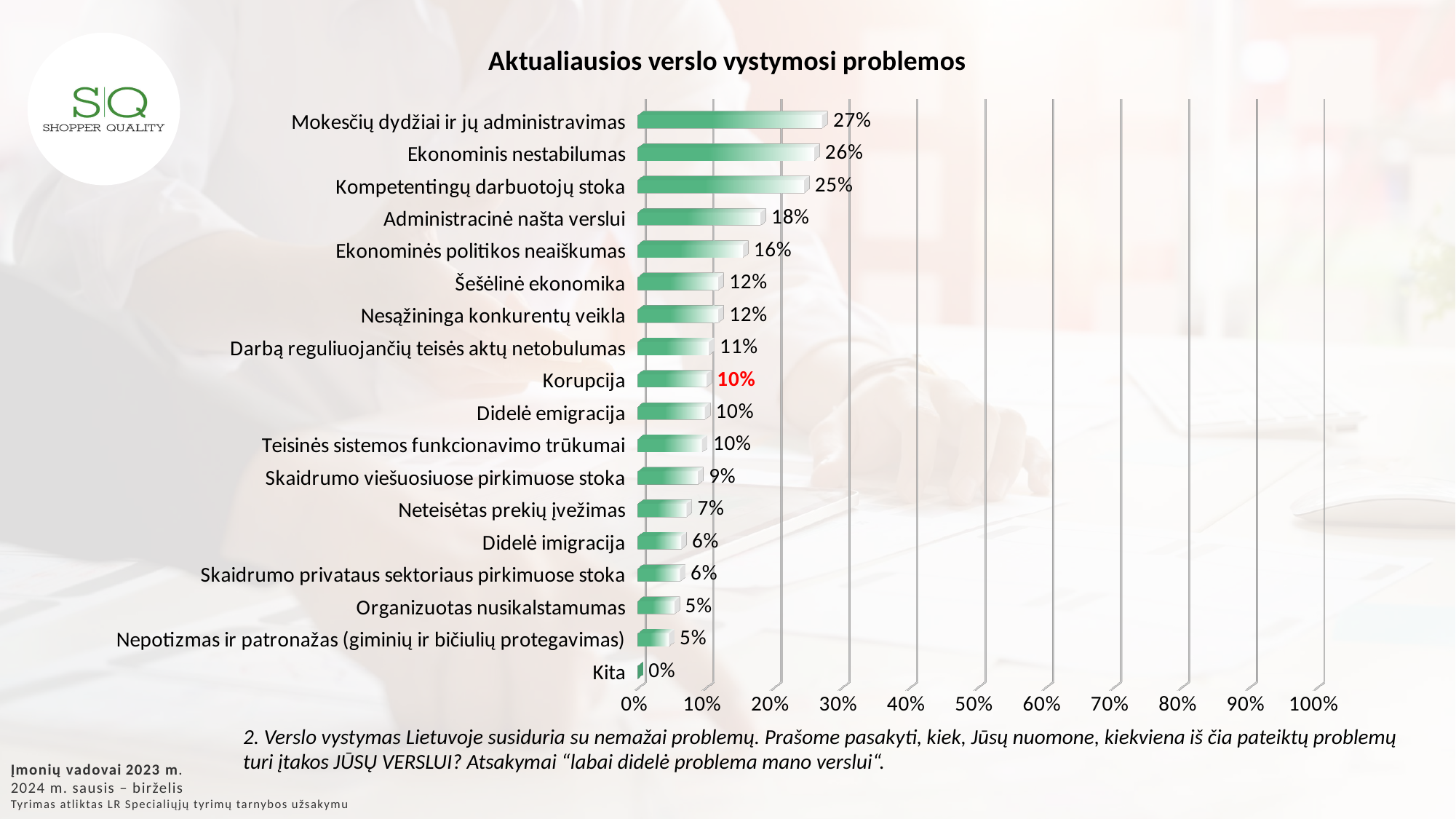
What is the value for Mokesčių dydžiai ir jų administravimas? 27% Which is larger, the value for Kompetentingų darbuotojų stoka or the value for Šešėlinė ekonomika? Kompetentingų darbuotojų stoka What is the value for Neteisėtas prekių įvežimas? 7% Which category has the highest value? Mokesčių dydžiai ir jų administravimas What is the value for Korupcija? 10% Is the value for Ekonominis nestabilumas greater or less than 20%? greater How many categories are shown in the chart? 18 Which category has the lowest value? Kita What kind of chart is shown on the slide? bar chart What is the value for Administracinė našta verslui? 18% What is the difference between the values for Ekonominis nestabilumas and Ekonominės politikos neaiškumas? 10% What is the title of the chart? Aktualiausios verslo vystymosi problemos